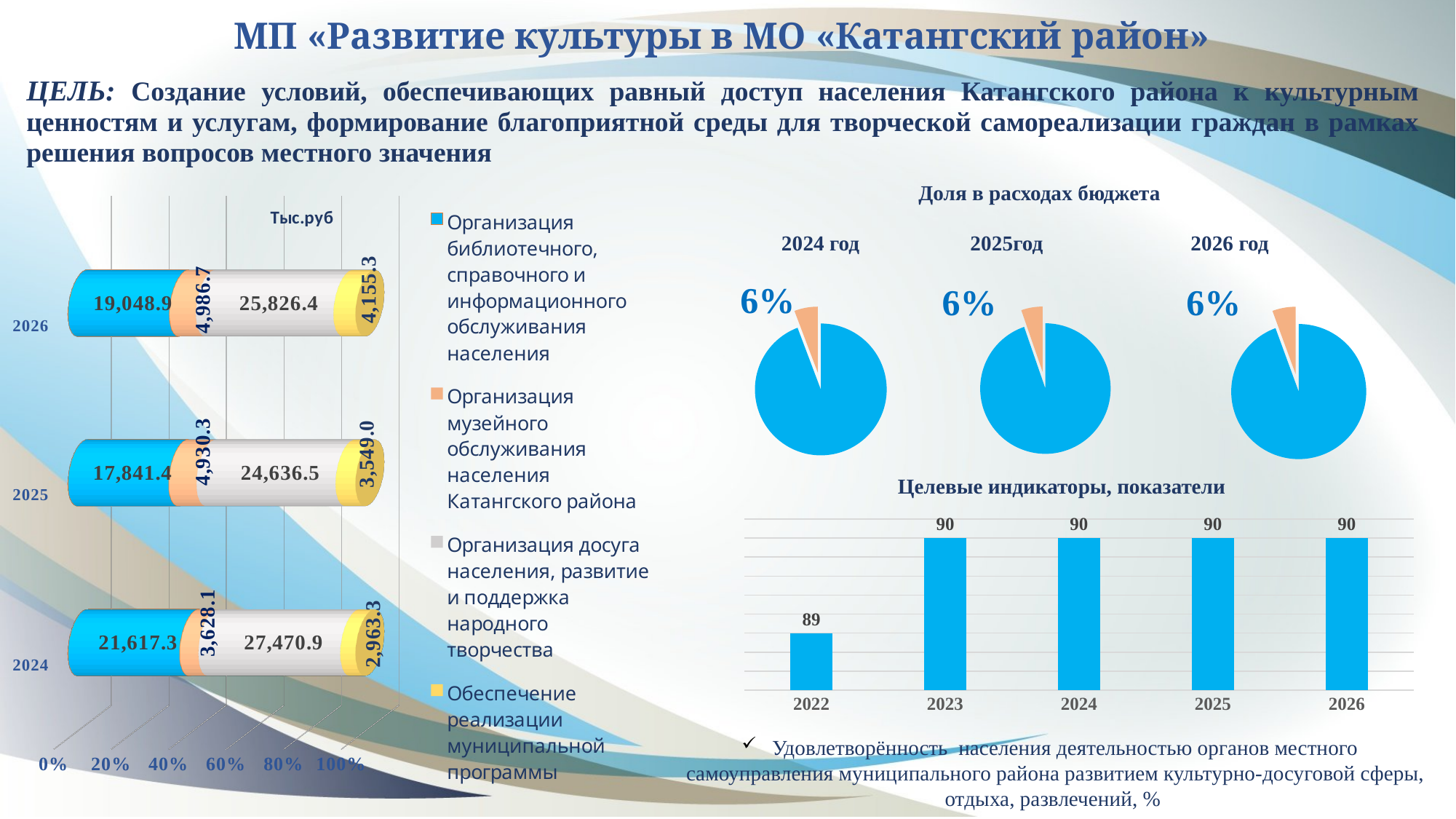
In the stacked bar chart on the left, what is the difference between the 'Организация досуга населения, развитие и поддержка народного творчества' values for 2024 and 2025? 2,834.4 In the stacked bar chart on the left, what is the value for 'Обеспечение реализации муниципальной программы' in 2025? 3,549.0 In the stacked bar chart on the left, what is the total of the 2024 bar? 55,679.6 In the stacked bar chart on the left, how many series does the legend list? 4 In the 'Целевые индикаторы, показатели' chart, what is the value for 2022? 89 In the stacked bar chart on the left, what is the value for 'Организация музейного обслуживания населения Катангского района' in 2024? 3,628.1 In the 'Целевые индикаторы, показатели' chart, which year has the lowest value? 2022 How many pie charts are shown under 'Доля в расходах бюджета'? 3 In the stacked bar chart on the left, which is larger: the 'Организация музейного обслуживания населения Катангского района' value for 2026 or for 2024? 2026 In the 'Доля в расходах бюджета' pie chart for 2024 год, what share is labelled? 6% What kind of chart is 'Целевые индикаторы, показатели'? bar chart In the stacked bar chart on the left, what is the value for 'Организация библиотечного, справочного и информационного обслуживания населения' in 2026? 19,048.9